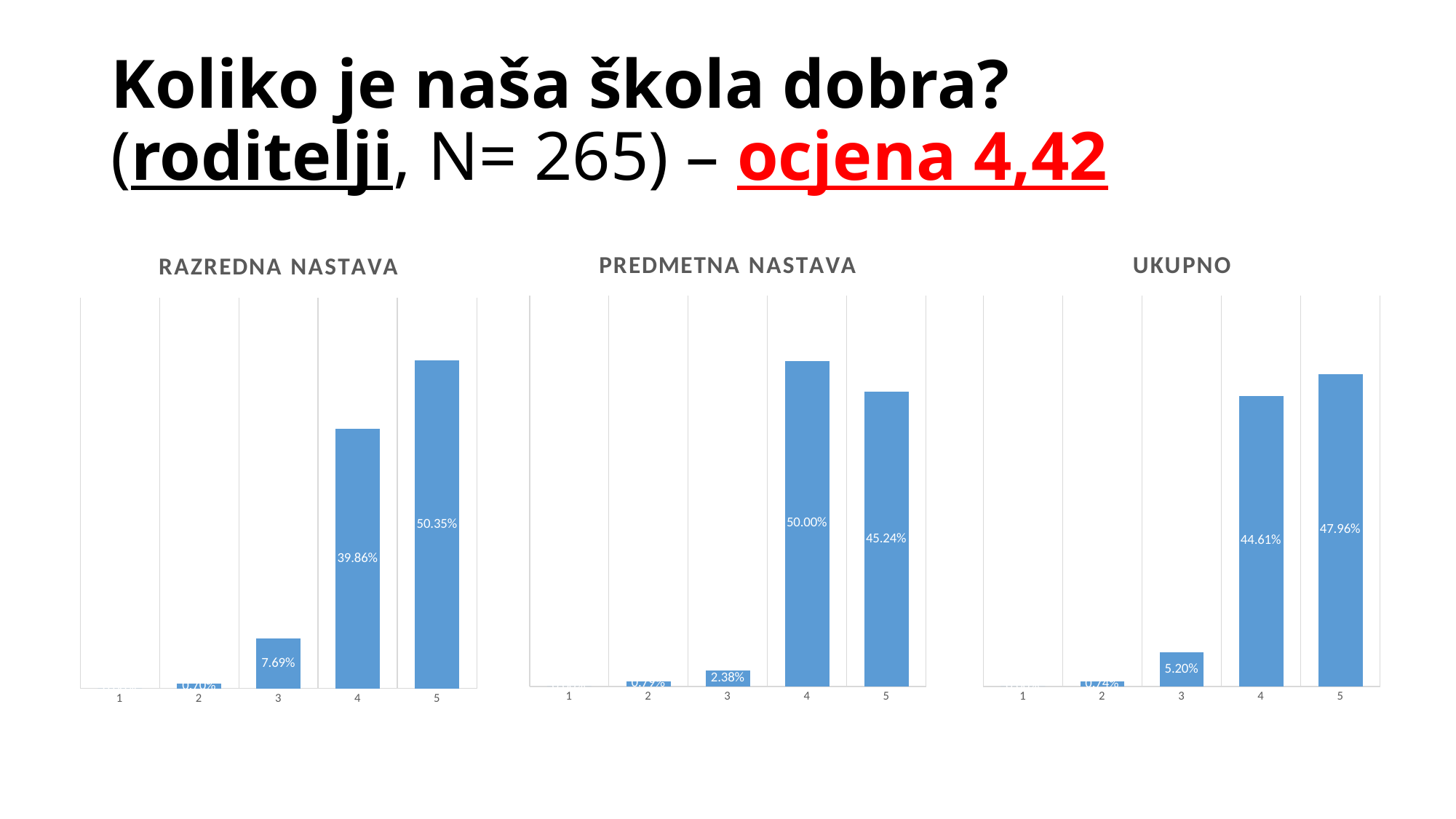
How many charts are shown on the slide? 3 In the UKUPNO chart, which category has the highest value? 5 In the RAZREDNA NASTAVA chart, what is the value for category 5? 50.35% In the PREDMETNA NASTAVA chart, what is the difference between the values for category 4 and category 5? 4.76% In the UKUPNO chart, which is larger, the value for category 3 or the value for category 4? 4 In the RAZREDNA NASTAVA chart, what is the value for category 4? 39.86% In the PREDMETNA NASTAVA chart, which category has the highest value? 4 In the PREDMETNA NASTAVA chart, what is the value for category 3? 2.38% What kind of chart is the UKUPNO chart? bar chart In the UKUPNO chart, what is the value for category 4? 44.61% In the RAZREDNA NASTAVA chart, which category has the lowest value? 1 How many categories are shown in the RAZREDNA NASTAVA chart? 5